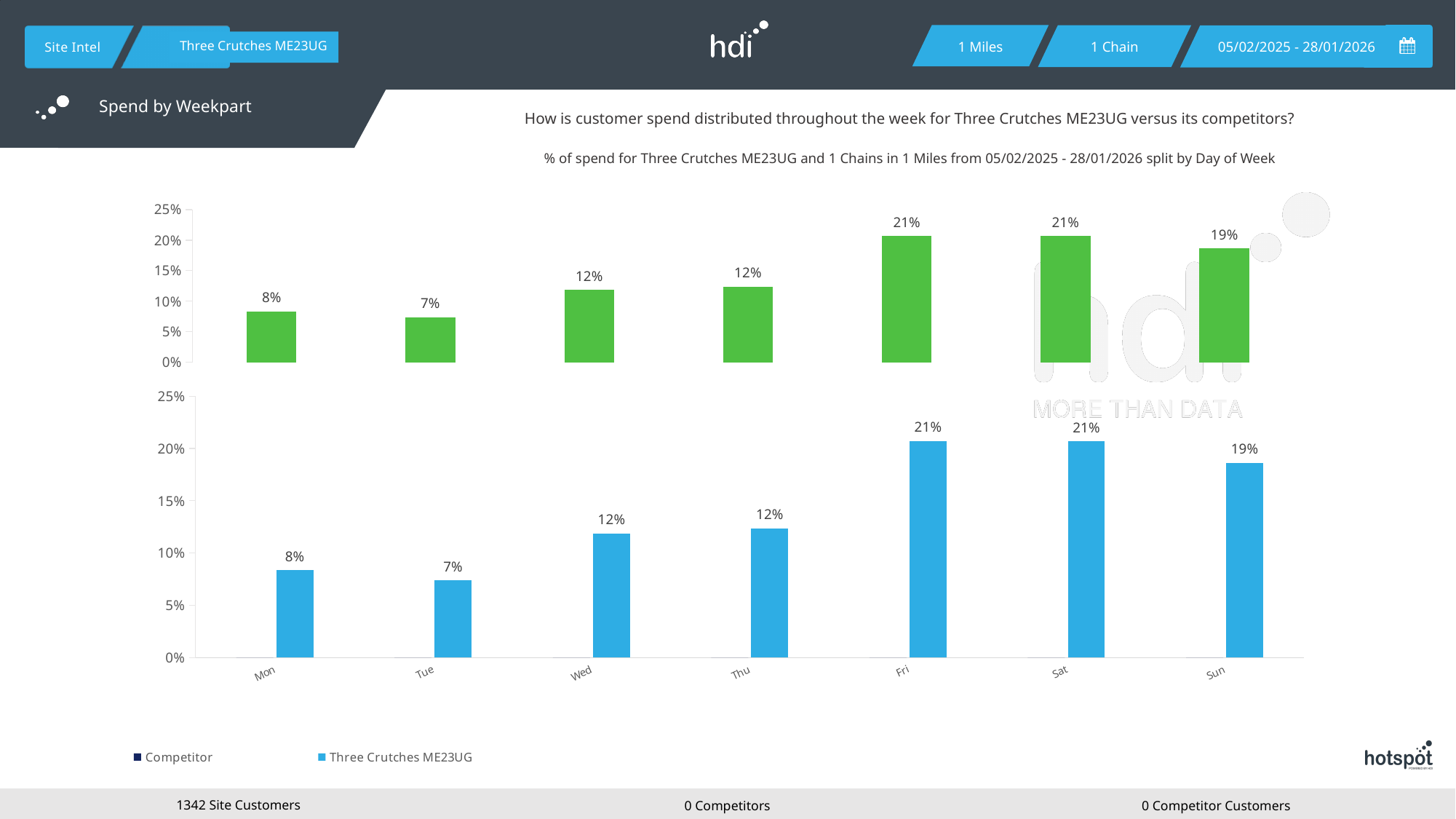
How many series does the legend of the bottom chart list? 2 What type of chart is the bottom chart? bar chart How many day-of-week categories are shown on the x axis of the bottom chart? 7 In the bottom chart, is the value for Three Crutches ME23UG on Sat larger or smaller than on Sun? larger In the bottom chart, what is the difference between the Sun value and the Tue value for Three Crutches ME23UG? 12% In the bottom chart, which day has the lowest value for Three Crutches ME23UG? Tue In the bottom chart, what is the value for Three Crutches ME23UG on Mon? 8% In the bottom chart, do the values for Three Crutches ME23UG rise or fall from Mon to Fri? rise What colour are the bars in the top chart? green In the top chart, what is the value shown for Wed? 12% In the top chart, is the value for Thu greater or less than 10%? greater In the bottom chart, what is the value for Three Crutches ME23UG on Fri? 21%